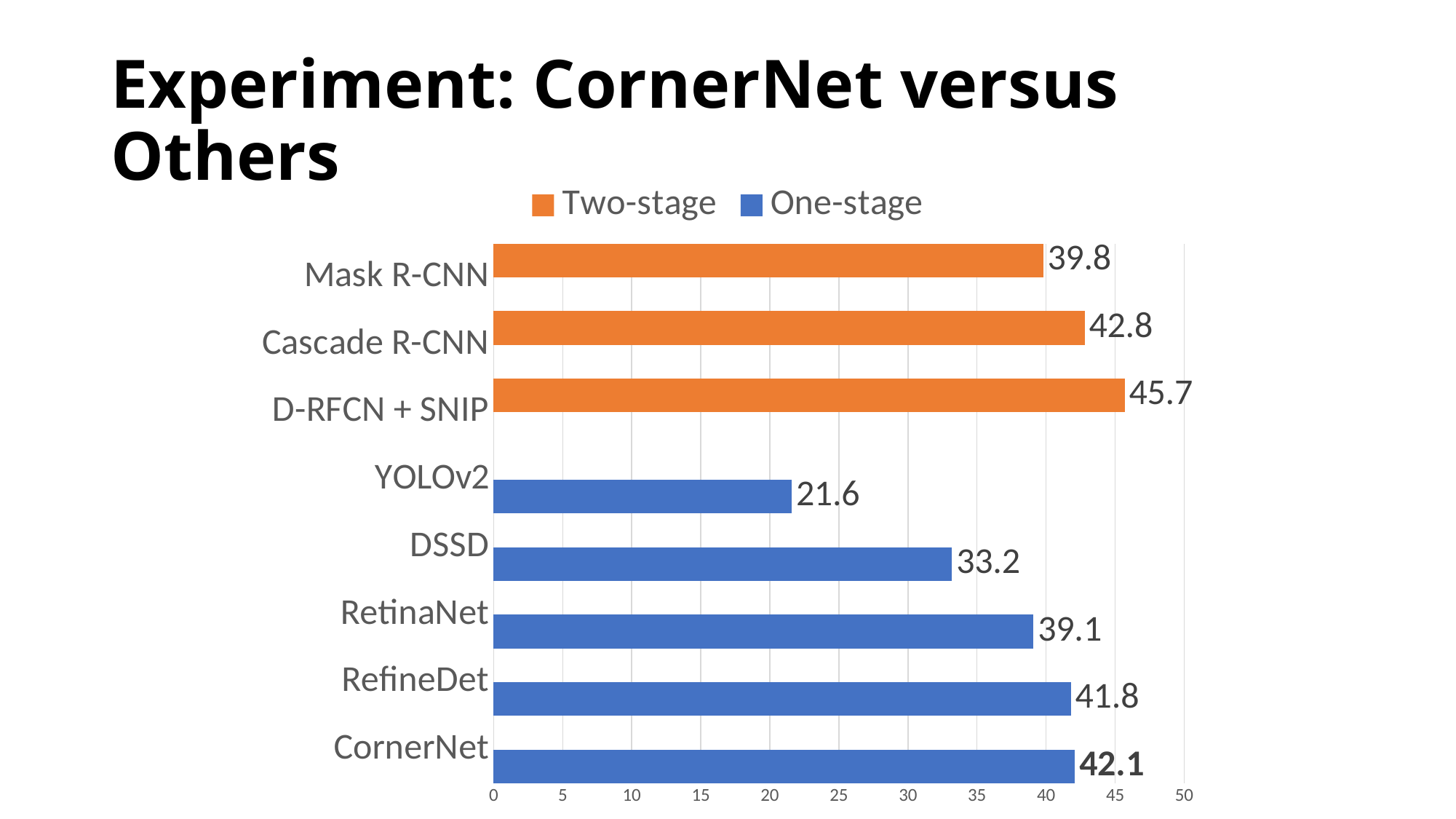
What is the value for CornerNet? 42.1 Which category has the lowest value? YOLOv2 What is the difference between the values for Cascade R-CNN and CornerNet? 0.7 Is the value for DSSD greater or less than 35? less What is the value for D-RFCN + SNIP? 45.7 How many categories are shown in the chart? 8 What is the value for YOLOv2? 21.6 Which is larger, the value for CornerNet or the value for RefineDet? CornerNet Which series is shown in orange? Two-stage What kind of chart is shown on the slide? bar chart How many series does the legend list? 2 Which category has the highest value? D-RFCN + SNIP